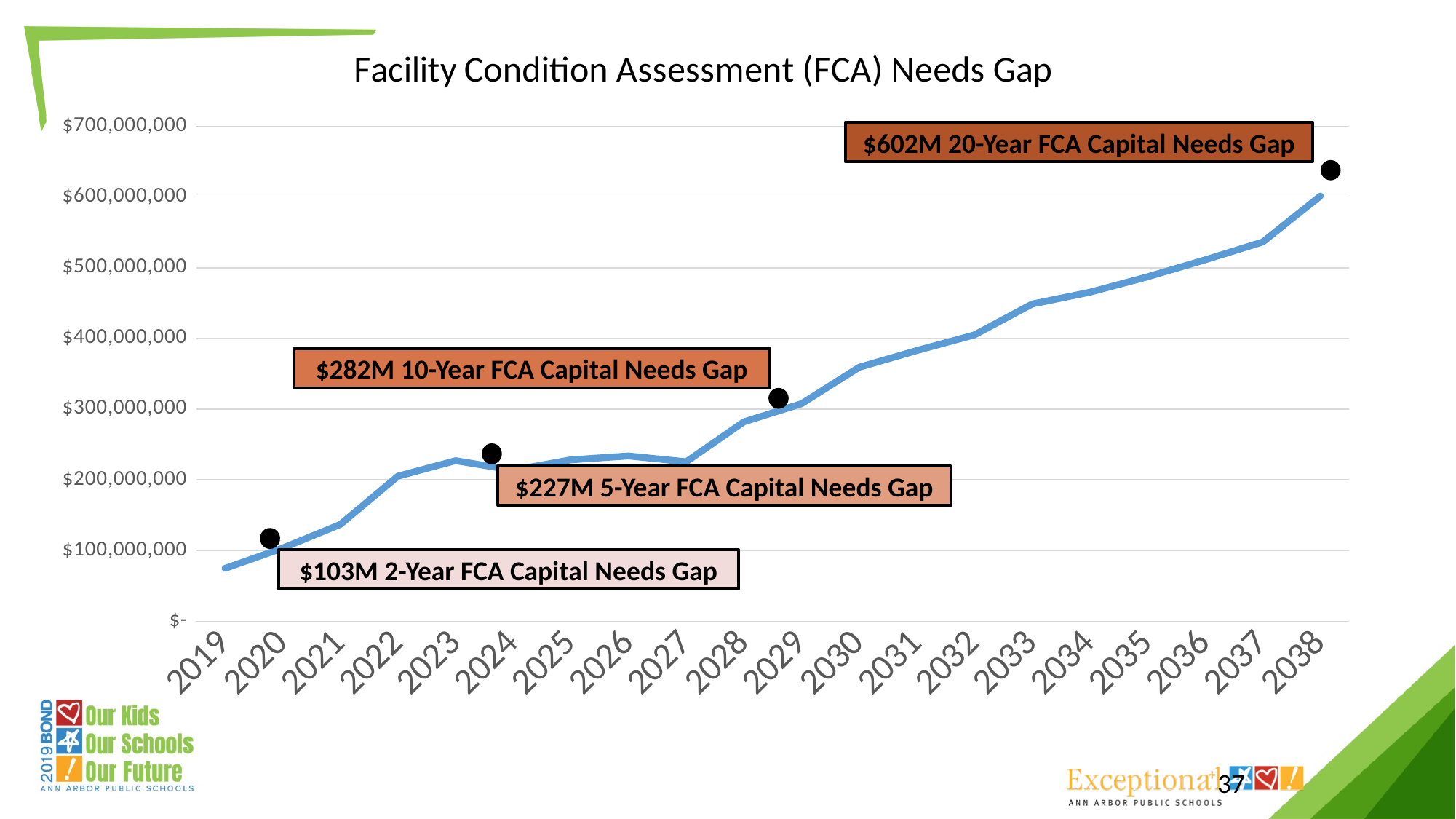
Which year has the highest value on the chart? 2038 According to the callout on the chart, what is the 10-Year FCA Capital Needs Gap? $282M What kind of chart is shown on the slide? line chart According to the callout on the chart, what is the 5-Year FCA Capital Needs Gap? $227M Is the value for 2019 greater or less than $100,000,000? less According to the callout on the chart, what is the 20-Year FCA Capital Needs Gap? $602M Which year has the lowest value on the chart? 2019 What is the title of the chart? Facility Condition Assessment (FCA) Needs Gap How many years are shown along the x axis of the chart? 20 Do the values on the chart generally rise or fall from 2019 to 2038? rise Is the value for 2038 greater or less than $500,000,000? greater According to the callout on the chart, what is the 2-Year FCA Capital Needs Gap? $103M